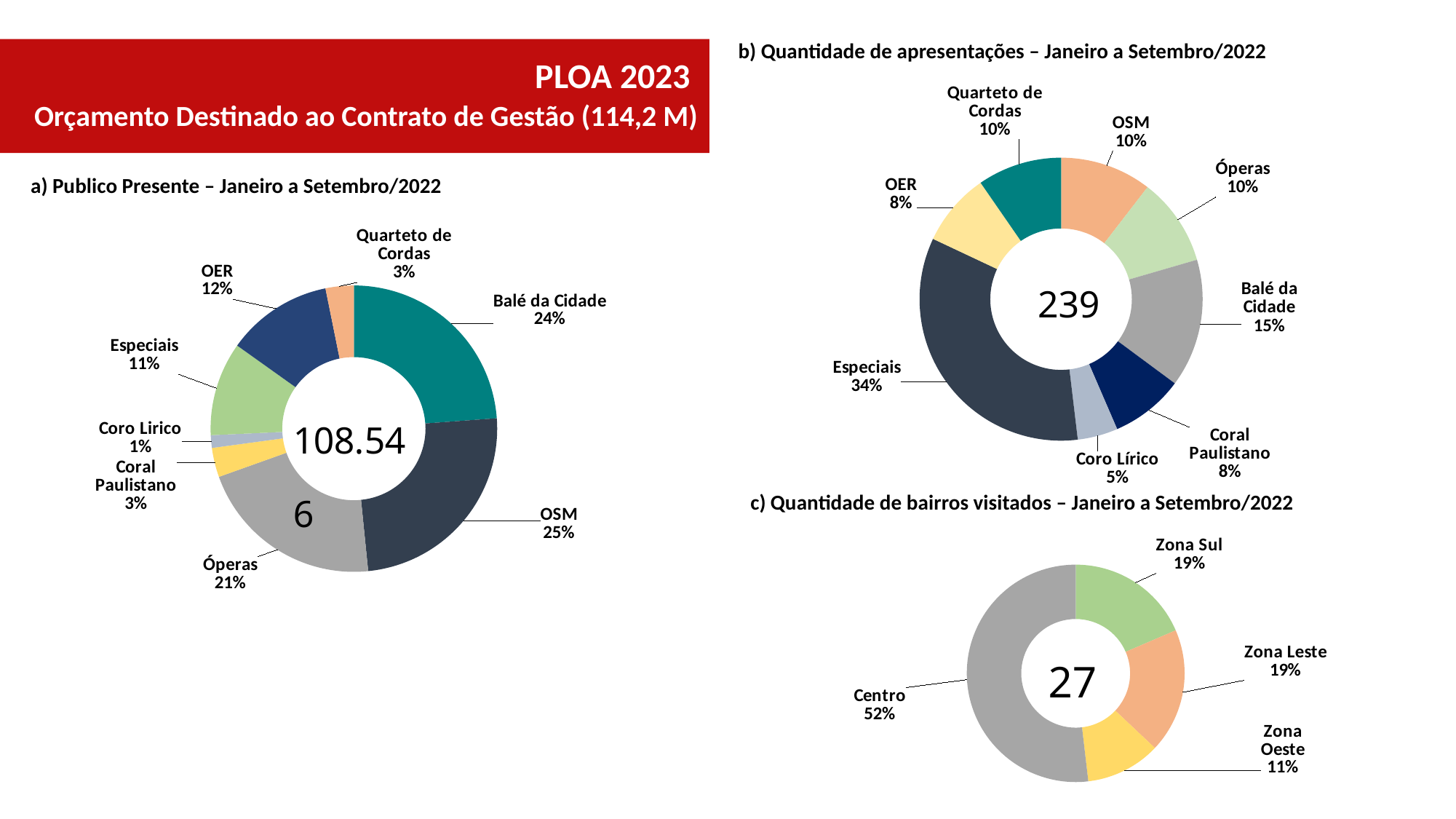
In the chart 'c) Quantidade de bairros visitados – Janeiro a Setembro/2022', what is the difference between the shares of Zona Sul and Zona Oeste? 8% In the chart 'a) Publico Presente – Janeiro a Setembro/2022', which category has the smallest share? Coro Lirico What type of chart is 'c) Quantidade de bairros visitados – Janeiro a Setembro/2022'? Pie (doughnut) chart In the chart 'b) Quantidade de apresentações – Janeiro a Setembro/2022', which category has the largest share? Especiais How many categories are shown in the chart 'c) Quantidade de bairros visitados – Janeiro a Setembro/2022'? 4 How many categories are shown in the chart 'a) Publico Presente – Janeiro a Setembro/2022'? 8 In the chart 'a) Publico Presente – Janeiro a Setembro/2022', what share does OSM have? 25% In the chart 'b) Quantidade de apresentações – Janeiro a Setembro/2022', what share does Balé da Cidade have? 15% In the chart 'c) Quantidade de bairros visitados – Janeiro a Setembro/2022', what share does Centro have? 52% What number is shown in the centre of the chart 'b) Quantidade de apresentações – Janeiro a Setembro/2022'? 239 In the chart 'a) Publico Presente – Janeiro a Setembro/2022', what is the difference between the shares of Balé da Cidade and Óperas? 3% In the chart 'b) Quantidade de apresentações – Janeiro a Setembro/2022', which is larger, the share of Coro Lírico or the share of Coral Paulistano? Coral Paulistano